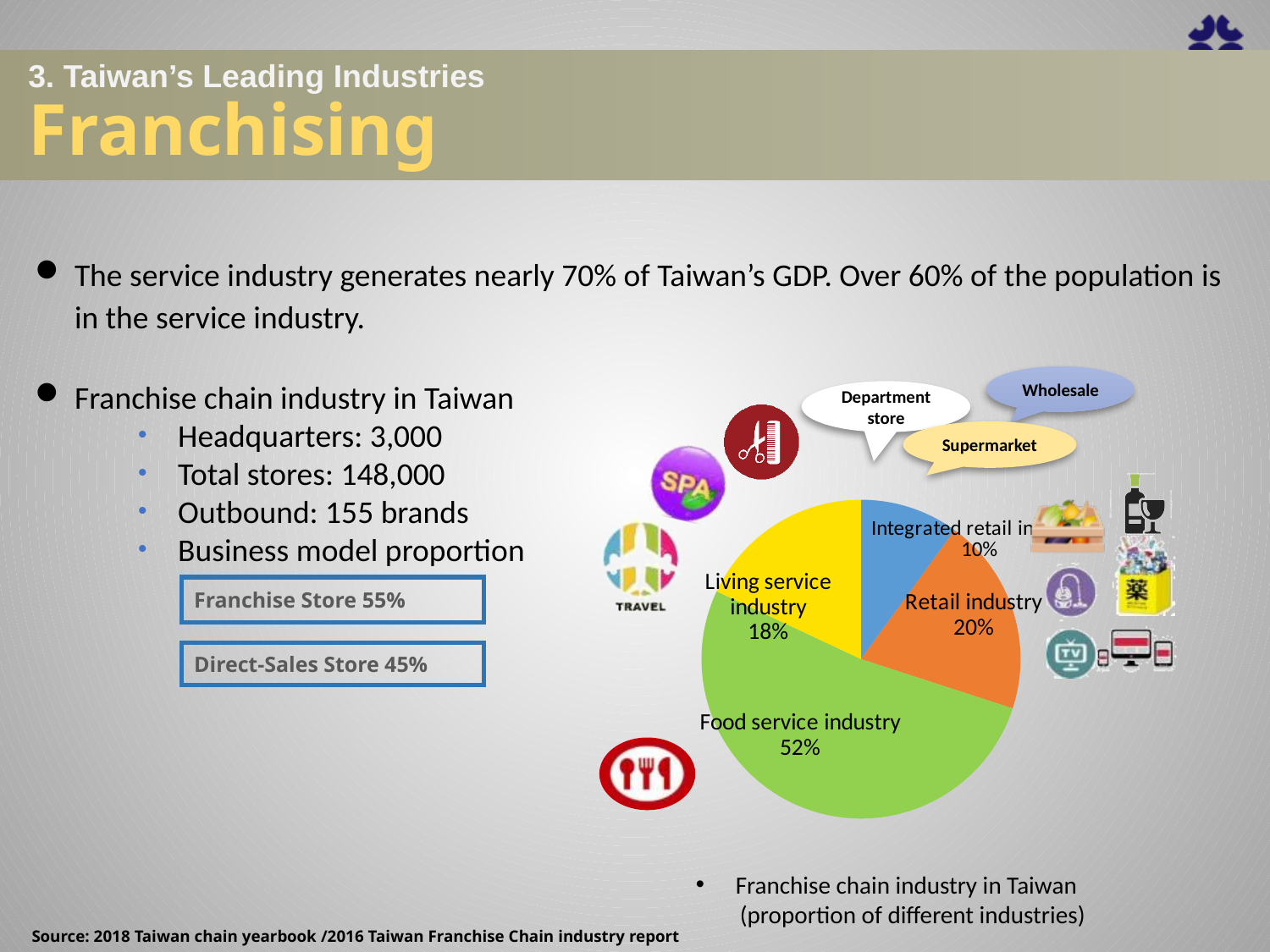
What colour is the Food service industry slice? green Which is larger, the Retail industry slice or the Living service industry slice? Retail industry What is the difference in percentage points between the Living service industry and the Integrated retail slice? 8 Which industry has the largest slice of the pie? Food service industry What type of chart is shown on the slide? pie chart What share of the pie does the Integrated retail slice hold? 10% How many slices does the pie chart have? 4 What share of the pie does the Retail industry hold? 20% What share of the pie does the Living service industry hold? 18% Which slice of the pie is the smallest? Integrated retail What is the difference in percentage points between the Food service industry and the Retail industry? 32